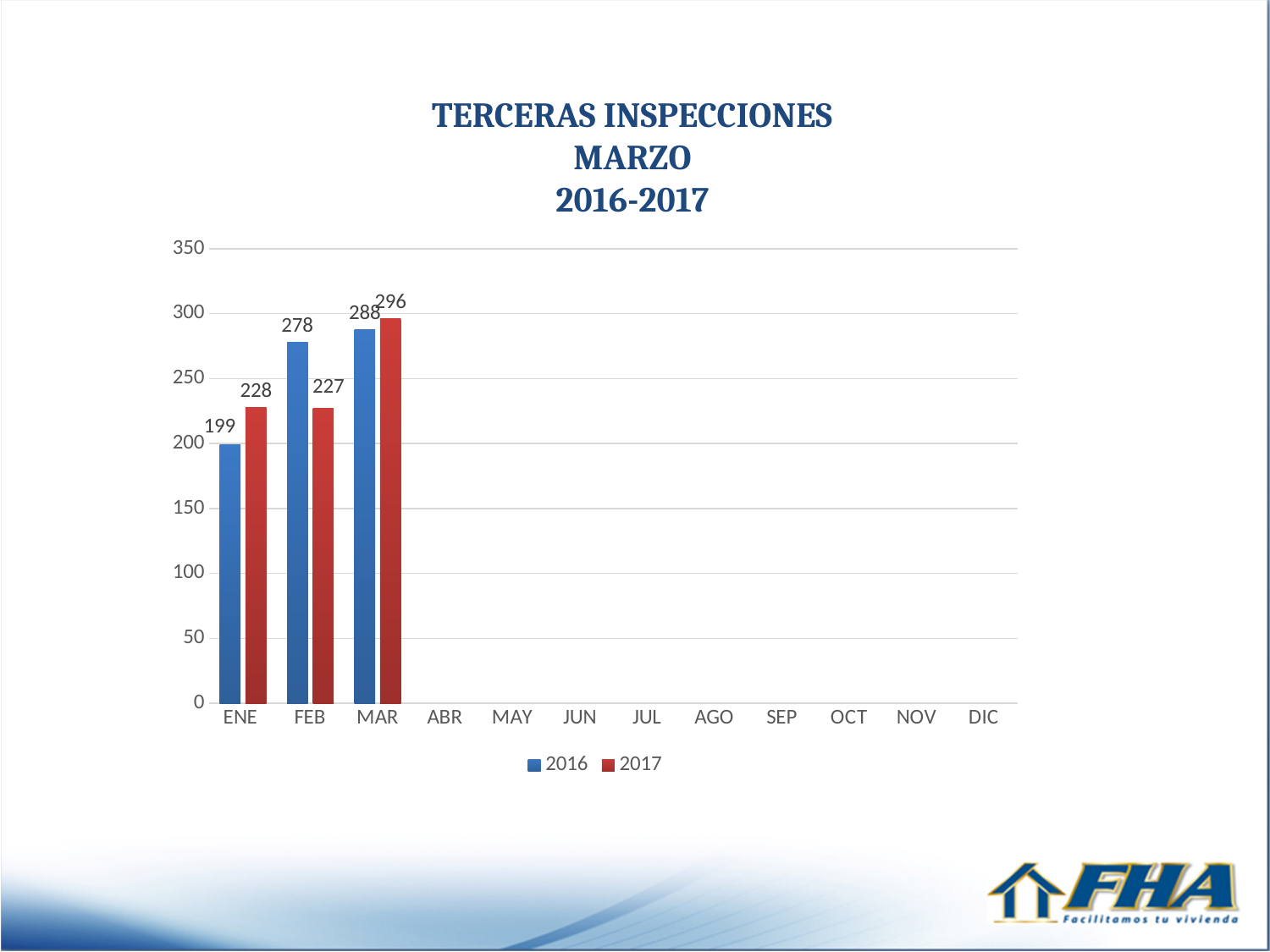
What is the value for 2017 in MAR? 296 How many series does the legend list? 2 Which month has the highest value for the 2017 series? MAR Which month has the lowest value for the 2016 series? ENE Is the value for 2016 in FEB greater or less than 250? greater What is the difference between the 2016 and 2017 values in FEB? 51 What kind of chart is shown on the slide? Bar chart What is the value for 2017 in FEB? 227 Do the 2016 values rise or fall from ENE to MAR? Rise What is the difference between the 2017 and 2016 values in ENE? 29 Which is larger in MAR, the 2016 value or the 2017 value? 2017 What is the value for 2016 in ENE? 199